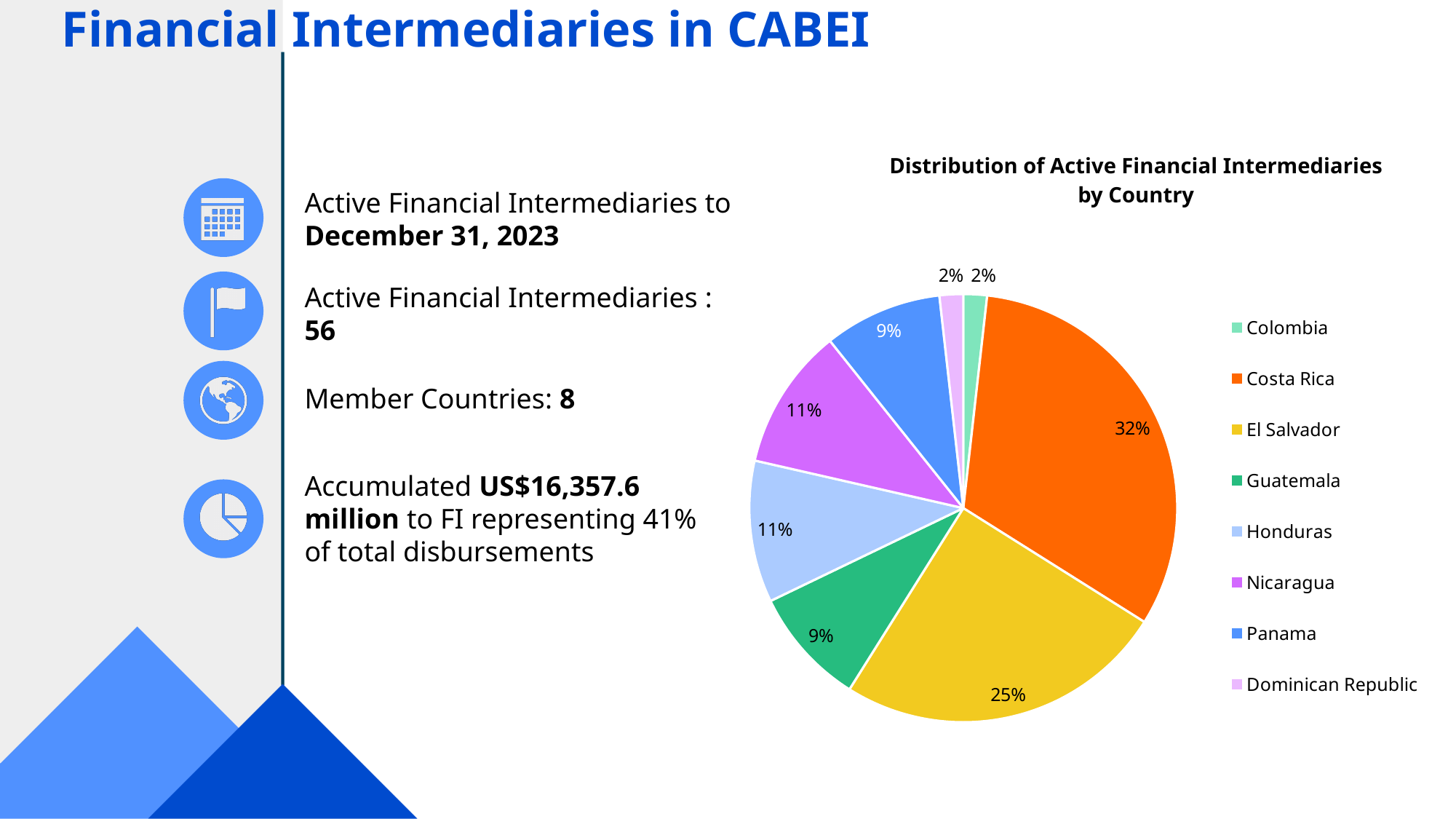
What share of the pie does Costa Rica represent? 32% What is the combined share of Costa Rica and El Salvador? 57% What percentage is shown for El Salvador? 25% How many countries are shown in the pie chart? 8 What percentage is shown for Honduras? 11% What is the title of the chart? Distribution of Active Financial Intermediaries by Country What percentage is shown for Guatemala? 9% What is the difference in percentage points between Costa Rica and El Salvador? 7 Which country has the largest slice of the pie? Costa Rica Which has a larger share, Nicaragua or Panama? Nicaragua What type of chart is used to show the distribution of active financial intermediaries? Pie chart What share of the pie does Dominican Republic represent? 2%